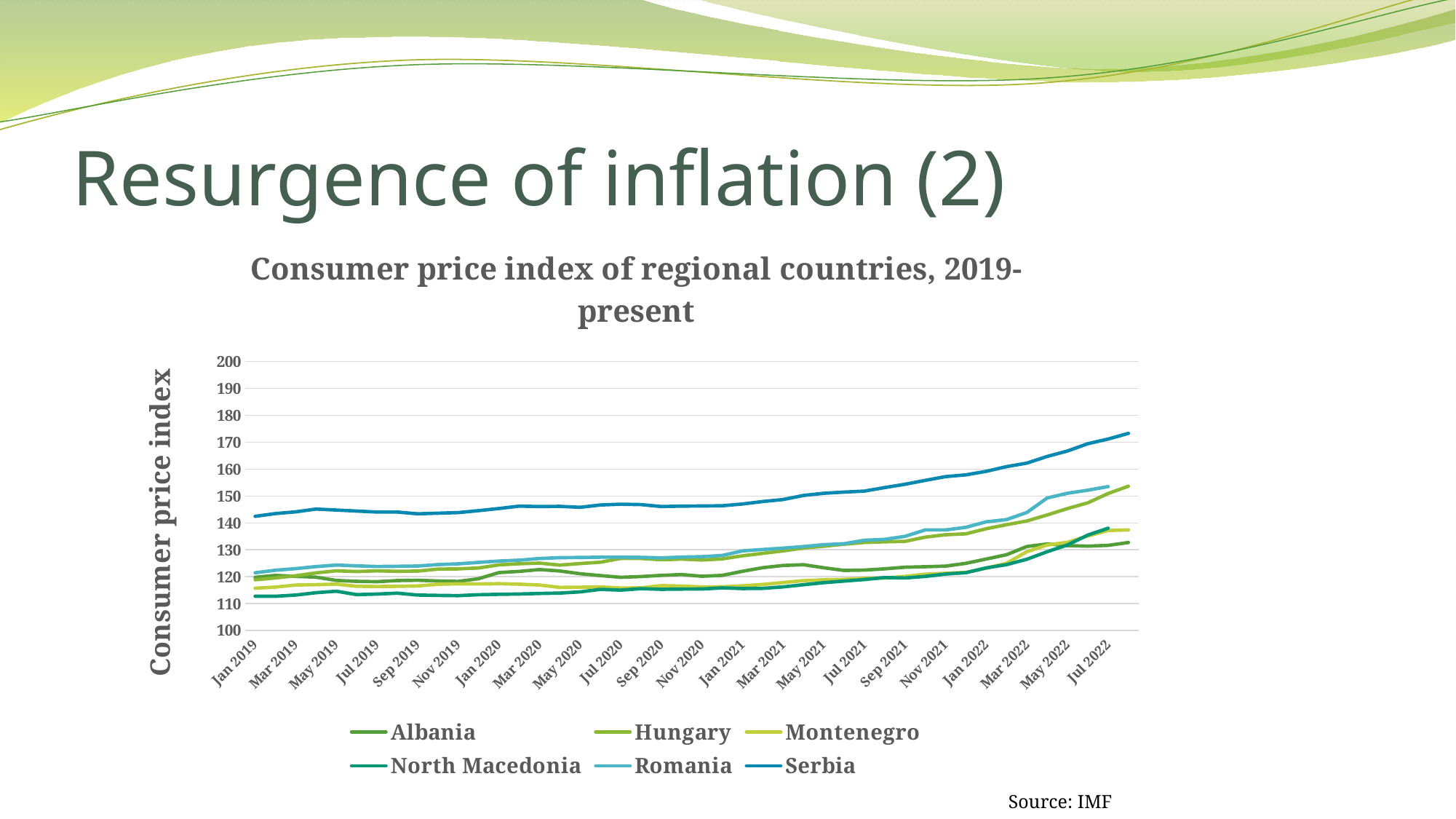
Is the value for Hungary in Jul 2022 greater or less than 140? greater Is the value for Serbia in Jul 2022 greater or less than 160? greater Which country has the lowest consumer price index in Jan 2019? North Macedonia What is the title of the chart? Consumer price index of regional countries, 2019-present Which is larger in Jul 2022, the value for Serbia or the value for Albania? Serbia How many series does the legend list? 6 Which country has the highest consumer price index in Jul 2022? Serbia Is the value for North Macedonia in Jan 2019 greater or less than 120? less How many month labels are shown on the x axis? 22 What kind of chart is shown on the slide? Line chart Does the consumer price index for Serbia rise or fall from Jan 2019 to Jul 2022? Rise